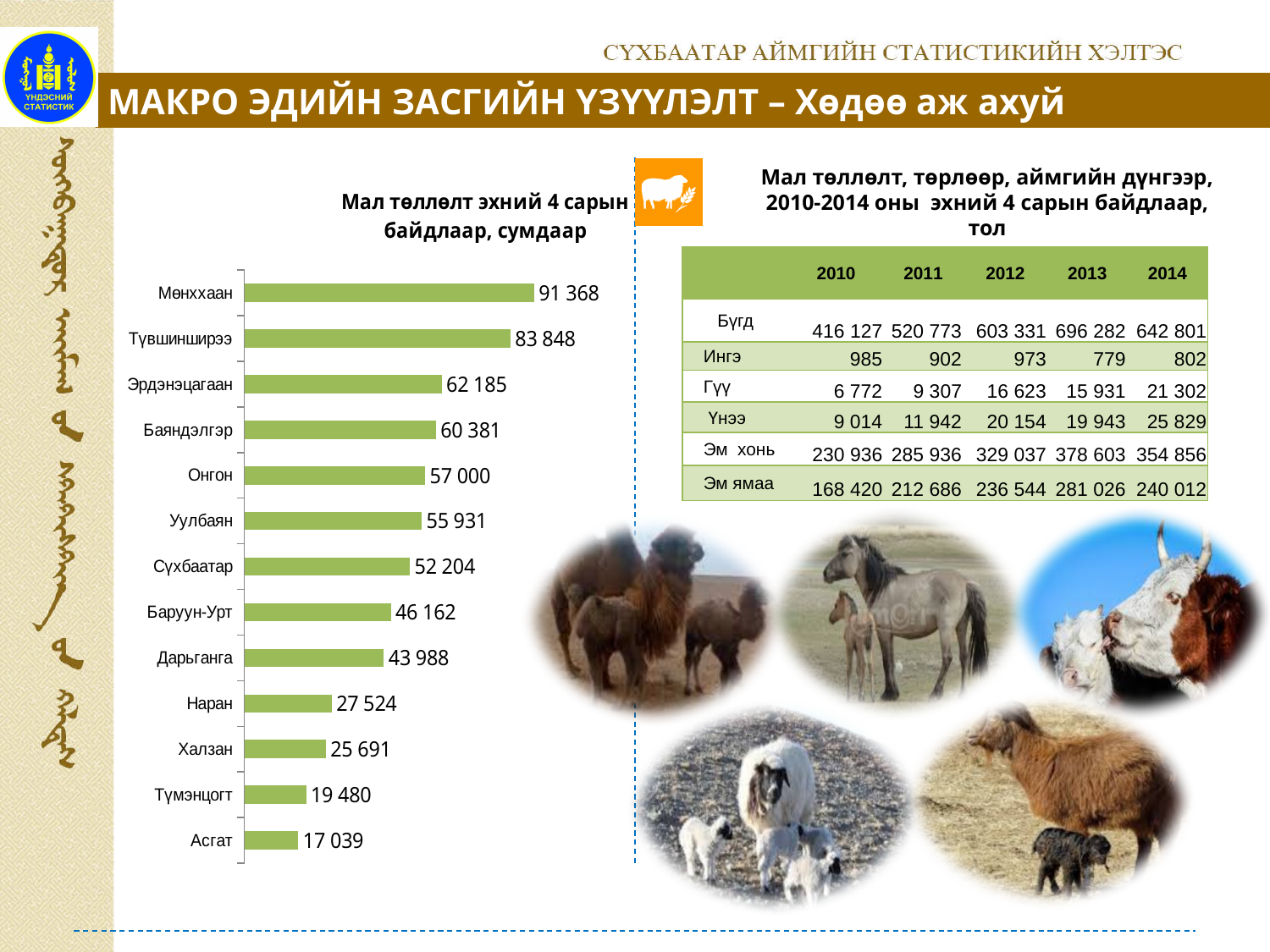
What is the difference between the values for Түмэнцогт and Асгат in the bar chart? 2 441 Which category has the highest value in the bar chart? Мөнххаан What is the difference between the values for Мөнххаан and Түвшинширээ in the bar chart? 7 520 What is the value for Мөнххаан in the bar chart? 91 368 How many categories are shown in the bar chart? 13 Which category has the lowest value in the bar chart? Асгат What is the value for Дарьганга in the bar chart? 43 988 Which has a larger value in the bar chart, Онгон or Баруун-Урт? Онгон What is the value for Сүхбаатар in the bar chart? 52 204 What is the title of the bar chart? Мал төллөлт эхний 4 сарын байдлаар, сумдаар Which has a larger value in the bar chart, Наран or Эрдэнэцагаан? Эрдэнэцагаан What kind of chart is shown on the left of the slide? Bar chart